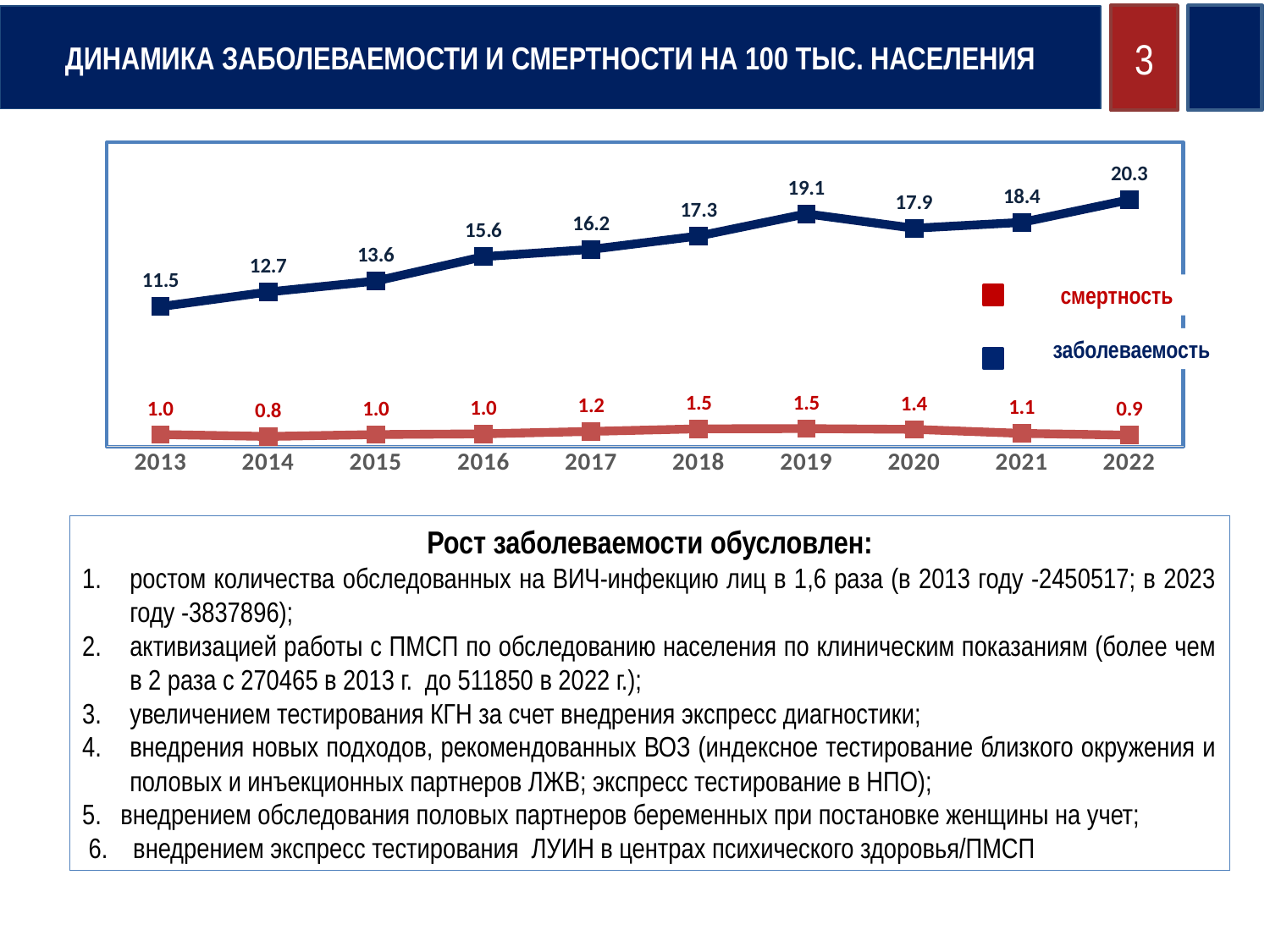
In which year is заболеваемость highest? 2022 In which year is смертность lowest? 2014 Which colour is used for the смертность series? red What is the value of заболеваемость in 2013? 11.5 What kind of chart is shown on the slide? line chart What is the value of смертность in 2018? 1.5 How many years are shown on the x axis? 10 What is the value of заболеваемость in 2019? 19.1 Which is larger: заболеваемость in 2019 or in 2020? 2019 Does заболеваемость generally rise or fall from 2013 to 2022? rise How many series does the legend list? 2 What is the difference between заболеваемость in 2022 and in 2013? 8.8